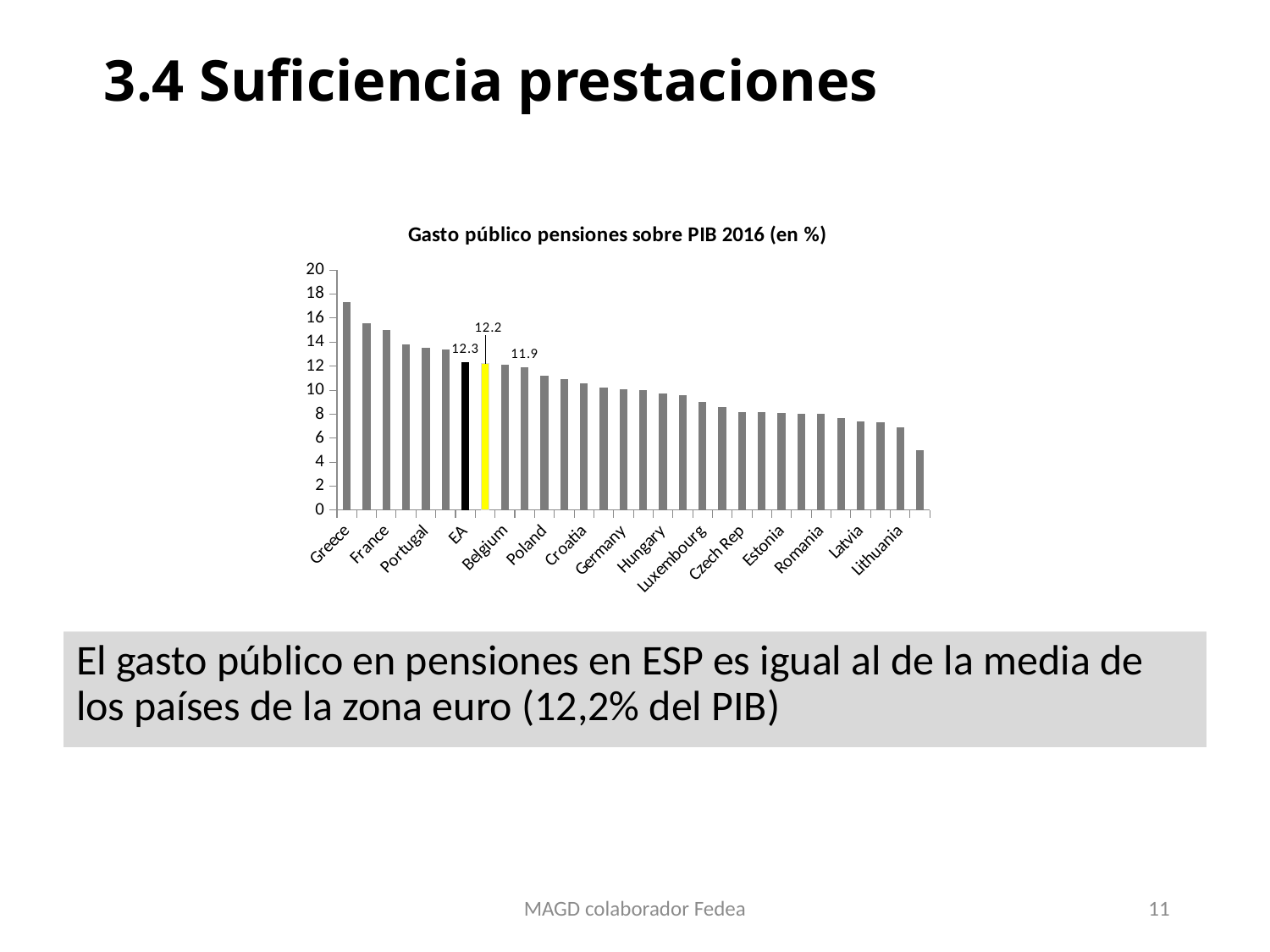
Which country has the highest public pension spending in the chart? Greece What value is printed on the yellow bar? 12.2 What value is printed on the black bar (EA)? 12.3 Which is larger, the value for Greece or the value for France? Greece Is the value for Greece greater or less than 16? greater Is the value for Czech Rep greater or less than 10? less What is the difference between the black bar (12.3) and the yellow bar (12.2)? 0.1 What is the title of the chart? Gasto público pensiones sobre PIB 2016 (en %) Is the value for Lithuania greater or less than 6? greater What kind of chart is shown on the slide? Bar chart Do the values rise or fall moving from left to right along the x axis? Fall